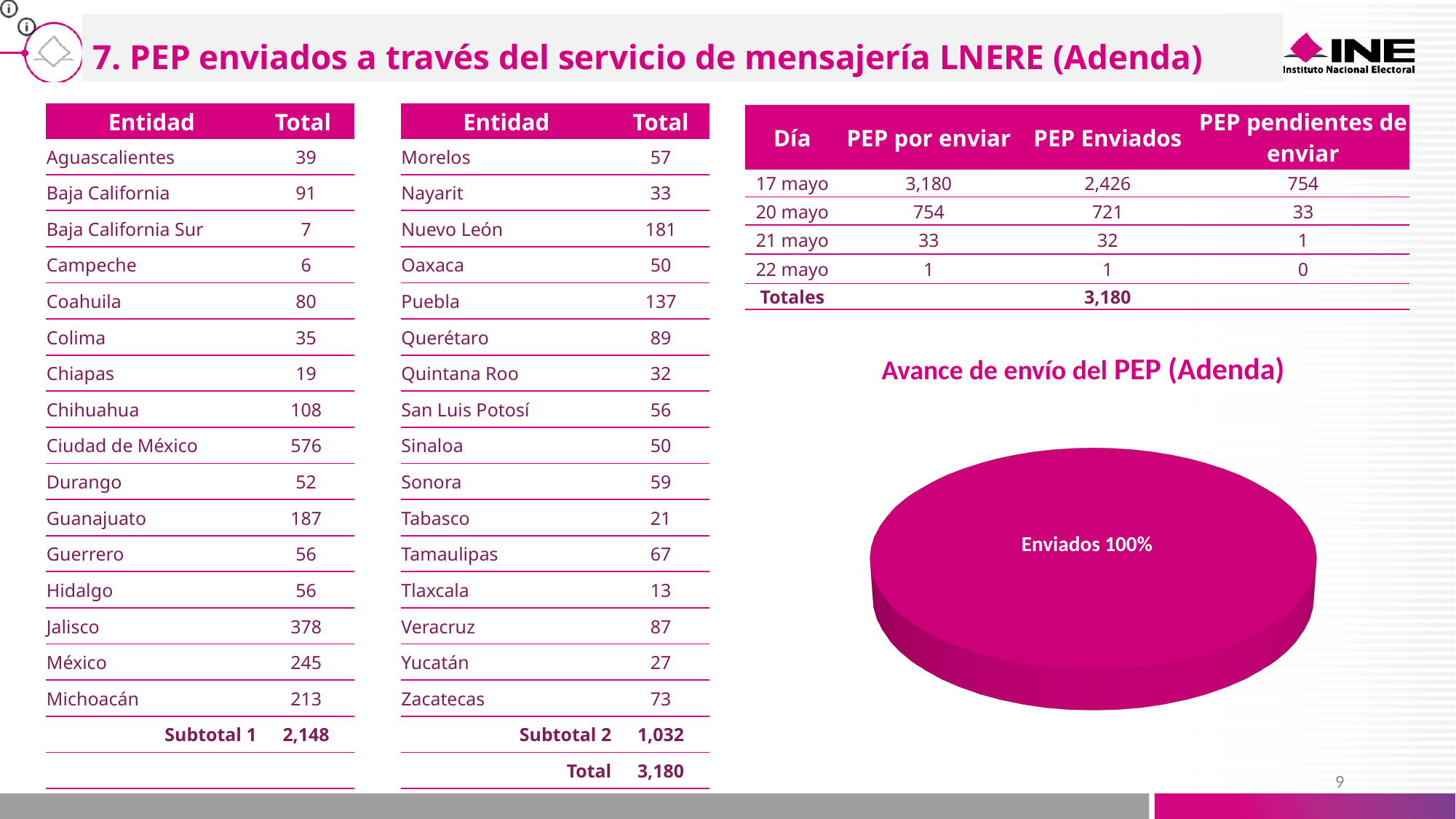
What colour is the slice of the pie chart? magenta What is the label printed on the pie chart's slice? Enviados 100% What is the title of the pie chart on the slide? Avance de envío del PEP (Adenda) What share of the pie chart does the "Enviados" slice represent? 100% What kind of chart is shown under the heading "Avance de envío del PEP (Adenda)"? pie chart How many slices does the pie chart contain? 1